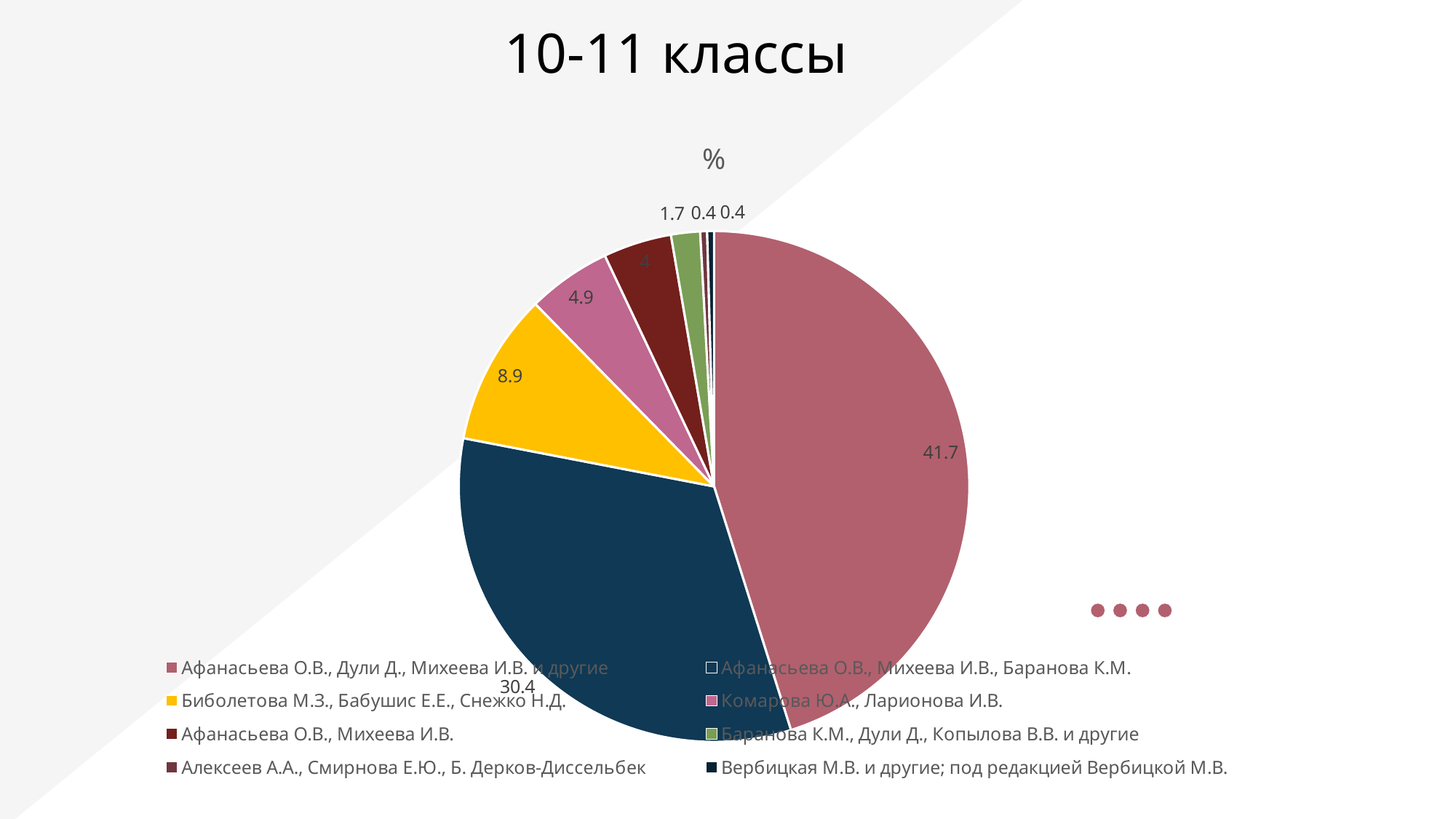
What is the value for Афанасьева О.В., Дули Д., Михеева И.В. и другие? 41.7 What is the value for Комарова Ю.А., Ларионова И.В.? 4.9 What type of chart is shown on the slide? pie chart Which is larger: the value for Биболетова М.З., Бабушис Е.Е., Снежко Н.Д. or the value for Комарова Ю.А., Ларионова И.В.? Биболетова М.З., Бабушис Е.Е., Снежко Н.Д. What colour is the slice for Биболетова М.З., Бабушис Е.Е., Снежко Н.Д.? yellow What is the value for Биболетова М.З., Бабушис Е.Е., Снежко Н.Д.? 8.9 What is the title of the chart? % How many entries does the chart legend list? 8 Which category has the largest slice of the pie? Афанасьева О.В., Дули Д., Михеева И.В. и другие What is the value for Баранова К.М., Дули Д., Копылова В.В. и другие? 1.7